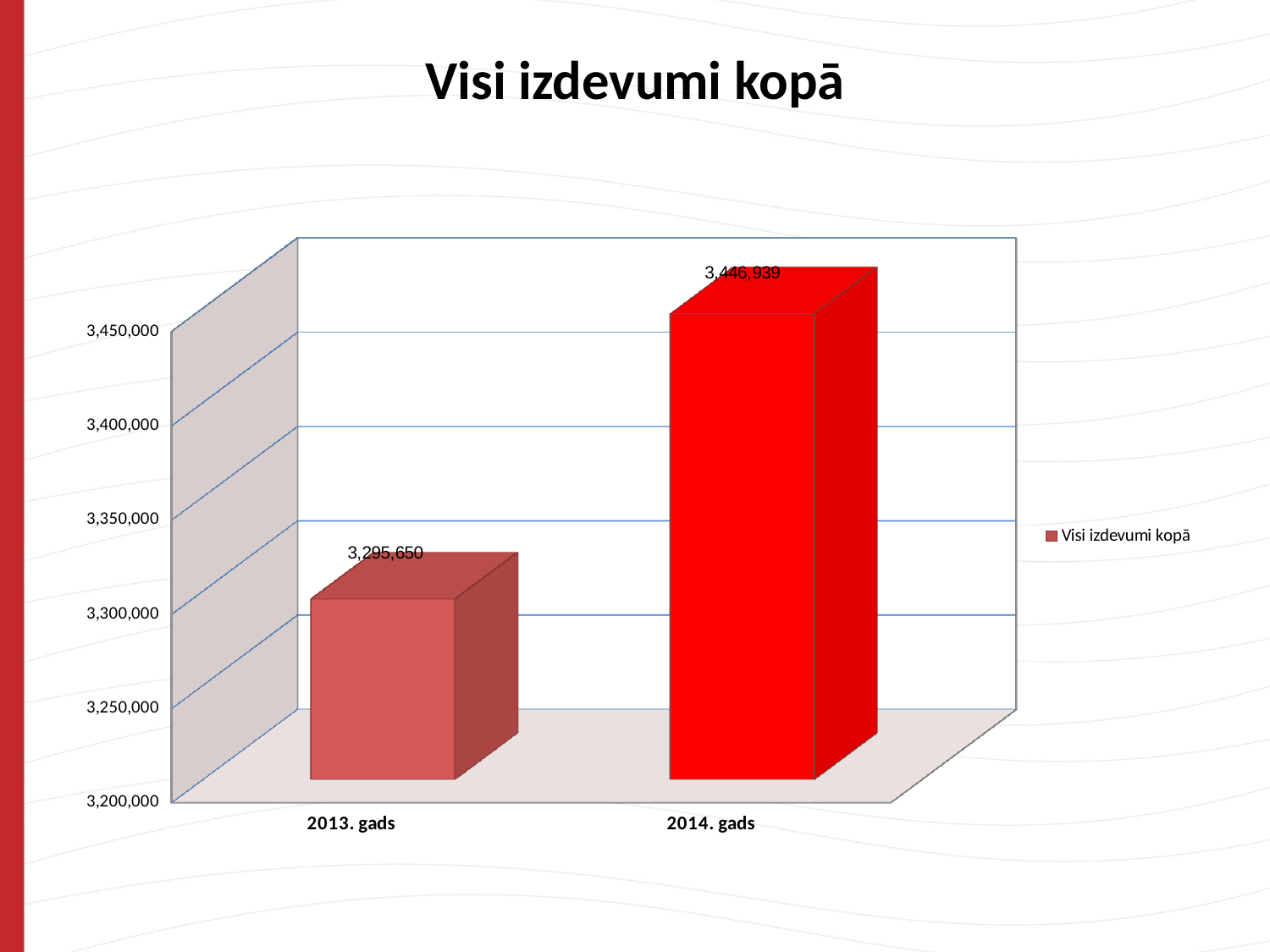
What is the value for 2013. gads? 3,295,650 Is the value for 2013. gads greater or less than 3,300,000? less What kind of chart is shown? Bar chart What is the difference between the values for 2014. gads and 2013. gads? 151,289 Is the value for 2014. gads greater or less than 3,400,000? greater Which year has the higher value? 2014. gads Is the value for 2014. gads larger than the value for 2013. gads? Yes What is the title of the chart? Visi izdevumi kopā How many categories are shown on the x axis? 2 What is the value for 2014. gads? 3,446,939 How many series does the legend list? 1 Which year has the lower value? 2013. gads